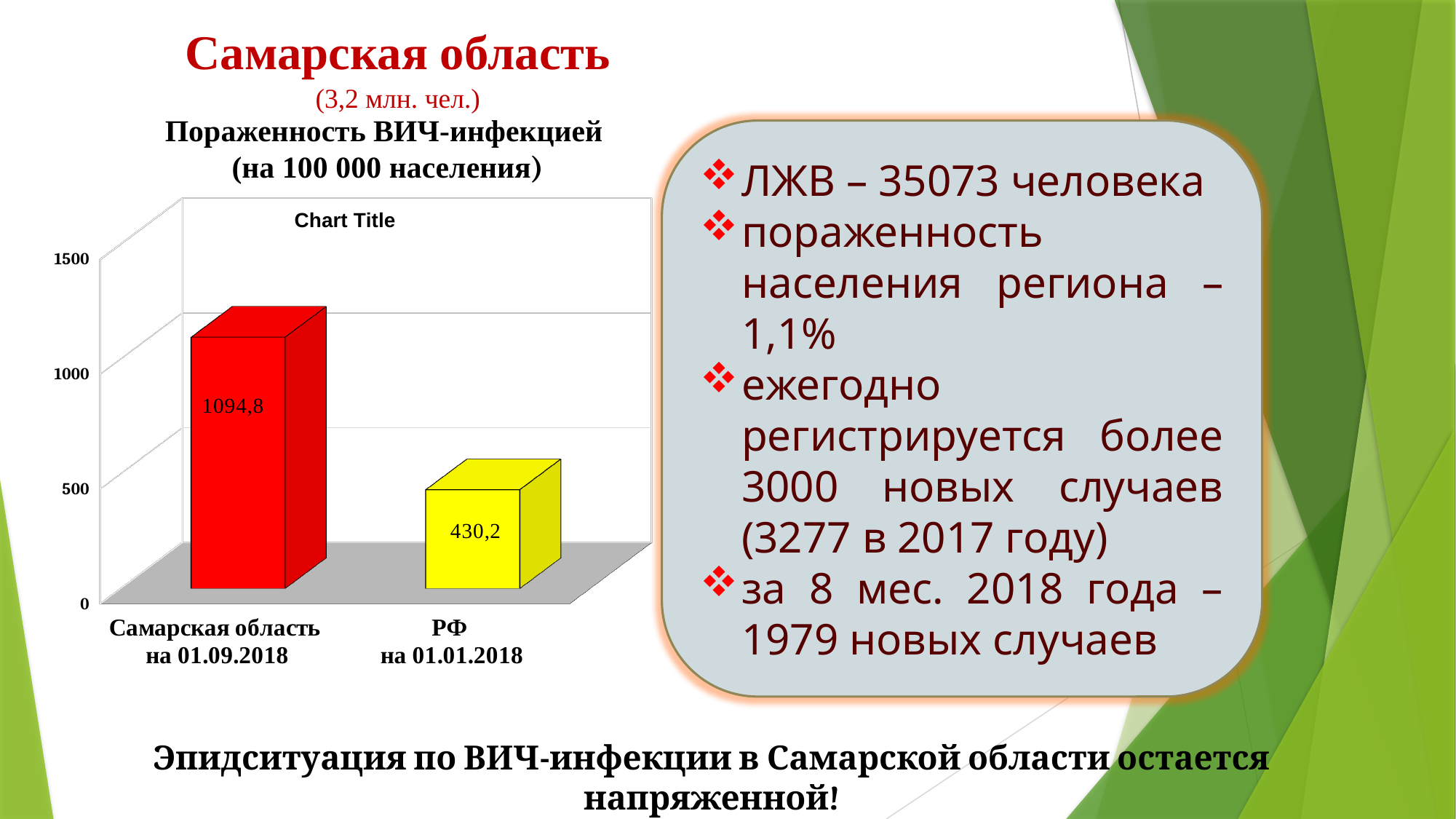
Which category has the lowest value? РФ на 01.01.2018 Which category has the highest value? Самарская область на 01.09.2018 What is the difference between the value for Самарская область на 01.09.2018 and the value for РФ на 01.01.2018? 664,6 Which is larger: the value for Самарская область на 01.09.2018 or the value for РФ на 01.01.2018? Самарская область на 01.09.2018 What kind of chart is shown on the slide? bar chart Is the value for Самарская область на 01.09.2018 greater or less than 1000? greater What colour is the bar for Самарская область на 01.09.2018? red Is the value for РФ на 01.01.2018 greater or less than 500? less What is the value for РФ на 01.01.2018? 430,2 What is the heading printed above the chart? Пораженность ВИЧ-инфекцией (на 100 000 населения) What is the value for Самарская область на 01.09.2018? 1094,8 How many categories are shown in the chart? 2